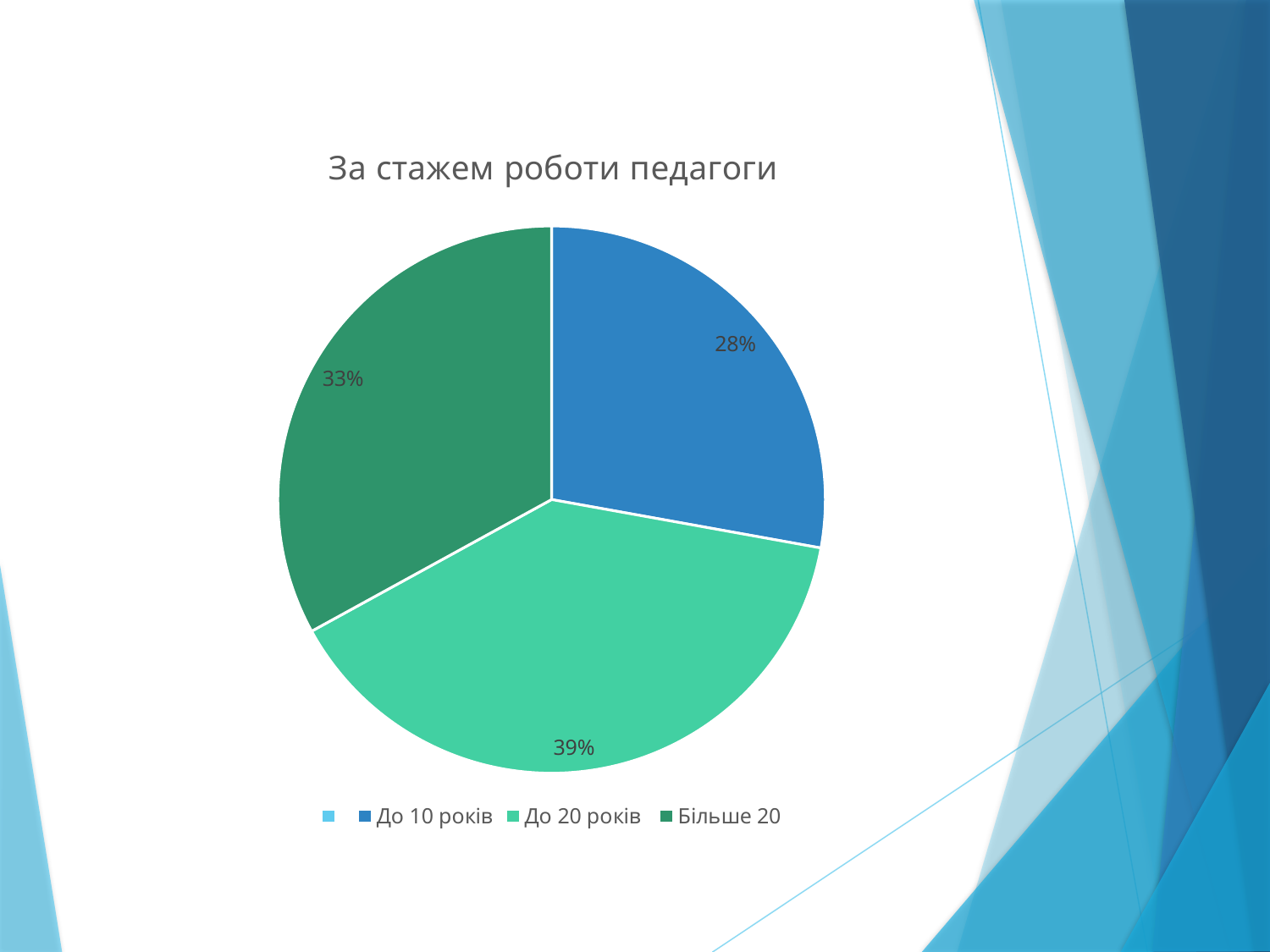
What kind of chart is shown on the slide? pie chart How many slices does the pie chart have? 3 What share of the pie does "До 10 років" take? 28% What colour is the slice for "До 10 років"? blue Which category has the largest slice of the pie? До 20 років Which is larger, the share for "Більше 20" or the share for "До 20 років"? До 20 років What share of the pie does "Більше 20" take? 33% What is the difference between the shares of "Більше 20" and "До 10 років"? 5% What is the difference between the shares of "До 20 років" and "До 10 років"? 11% Which category has the smallest slice of the pie? До 10 років What is the title of the chart? За стажем роботи педагоги What share of the pie does "До 20 років" take? 39%